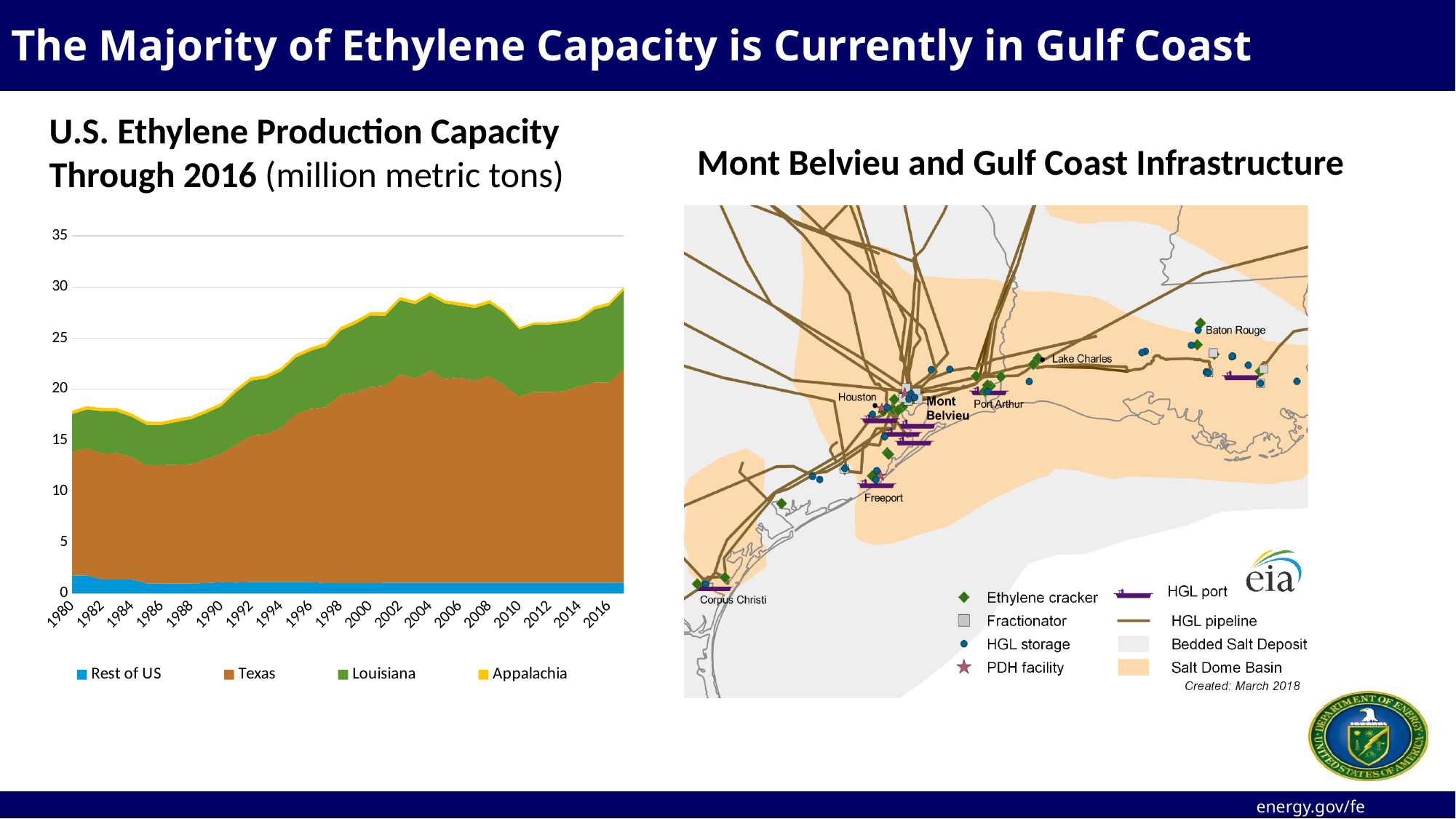
In the U.S. Ethylene Production Capacity chart, which region accounts for the largest share of capacity? Texas What kind of chart is the U.S. Ethylene Production Capacity chart? Stacked area chart In the U.S. Ethylene Production Capacity chart, is the total capacity in 2004 greater or less than 25? greater In the U.S. Ethylene Production Capacity chart, is the total capacity in 1980 greater or less than 20? less In the U.S. Ethylene Production Capacity chart, which colour represents Louisiana? Green In the U.S. Ethylene Production Capacity chart, is the total capacity in 1980 greater or less than 15? greater In the U.S. Ethylene Production Capacity chart, does total capacity generally rise or fall from 1980 to 2016? rise What unit is given in the title of the U.S. Ethylene Production Capacity chart? million metric tons In the U.S. Ethylene Production Capacity chart, which region accounts for the smallest share of capacity? Appalachia How many series does the legend of the U.S. Ethylene Production Capacity chart list? 4